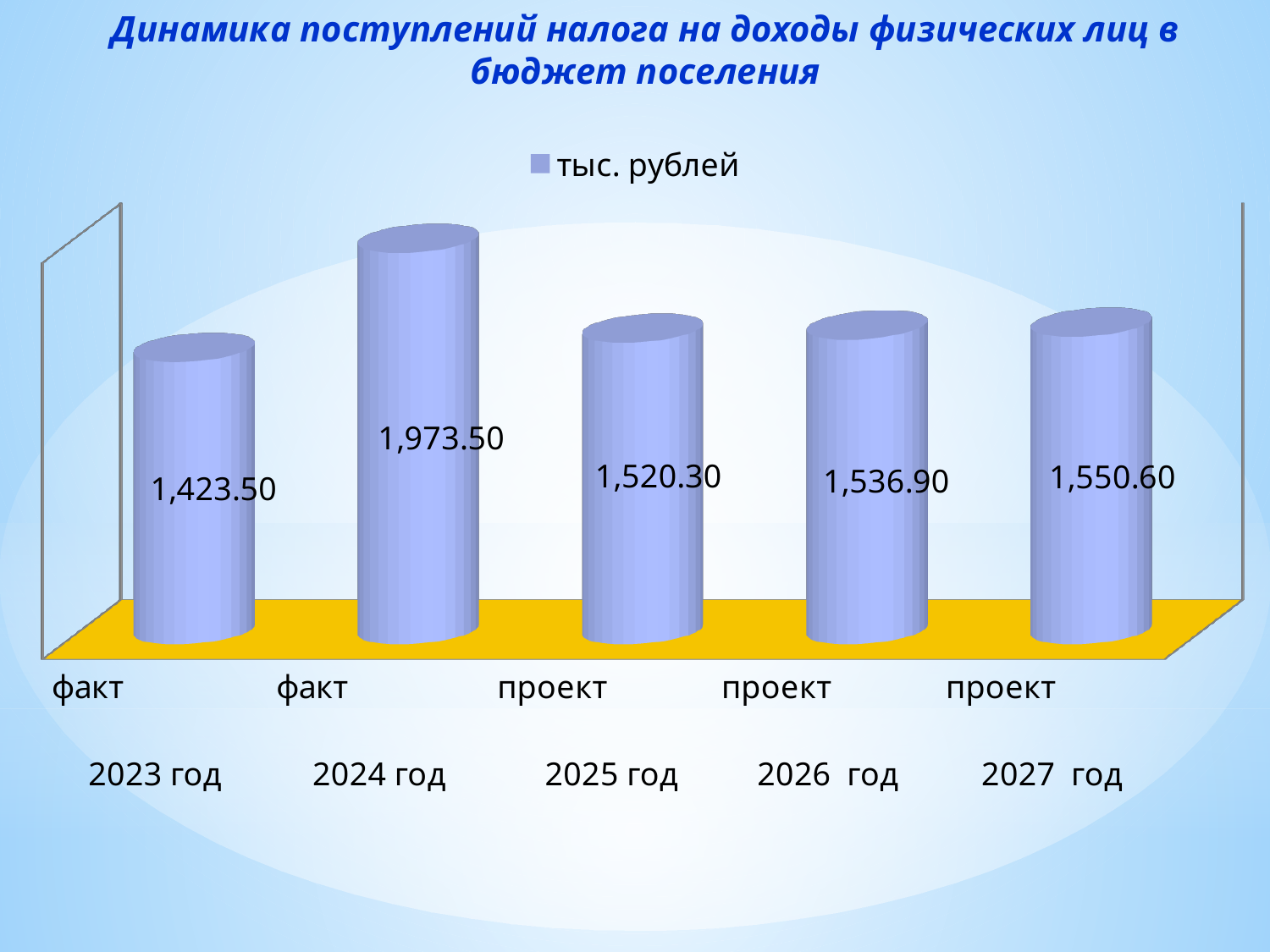
What is the value for 2024 год? 1,973.50 Do the values rise or fall from 2025 год to 2027 год? rise What is the difference between the values for 2024 год and 2023 год? 550.00 Which year has the highest value? 2024 год Which year has the lowest value? 2023 год What is the difference between the values for 2027 год and 2025 год? 30.30 How many series does the legend list? 1 Which is larger, the value for 2024 год or the value for 2025 год? 2024 год How many years are shown on the chart? 5 What is the value for 2027 год? 1,550.60 What is the value for 2023 год? 1,423.50 What kind of chart is shown on the slide? bar chart